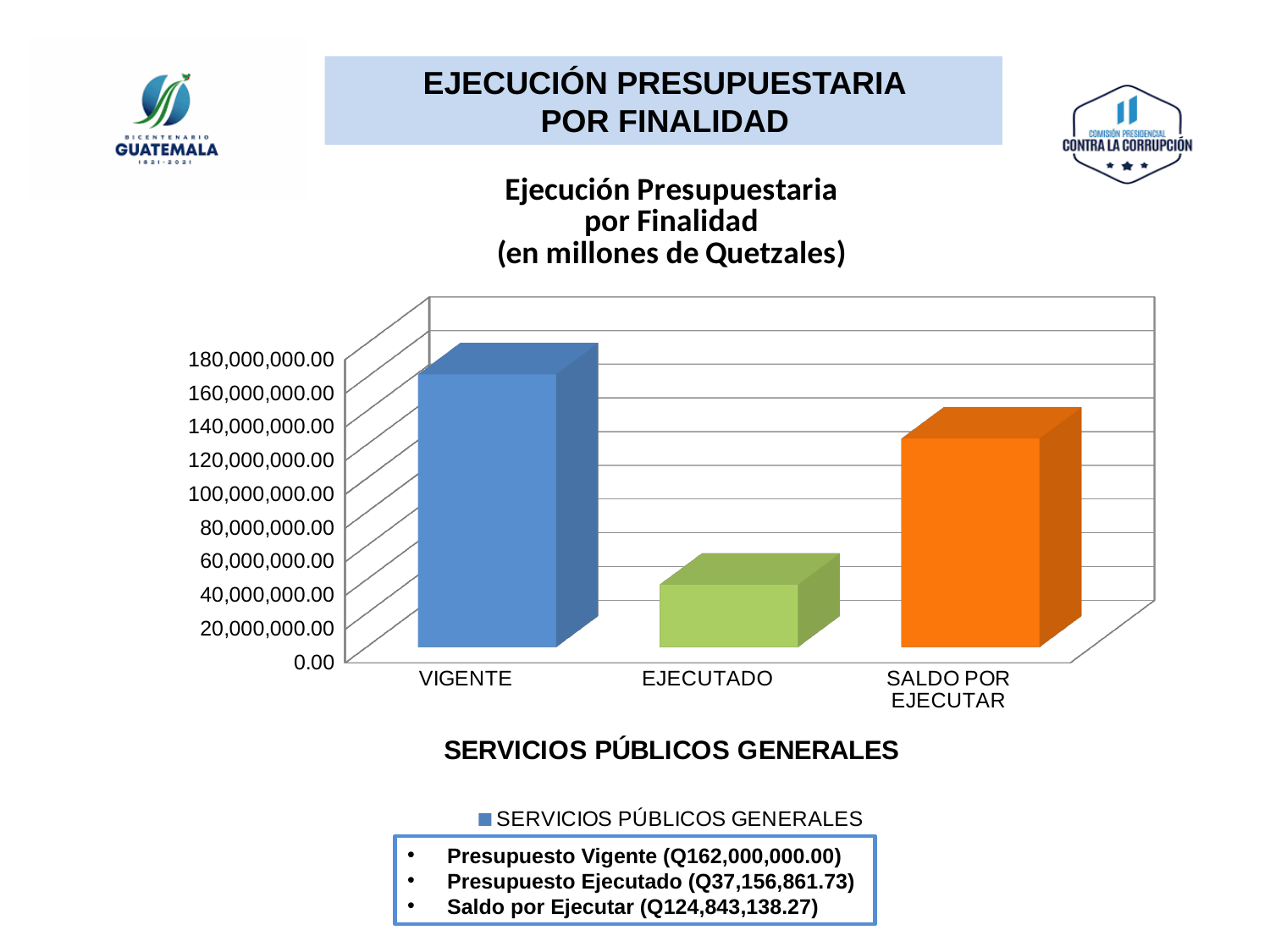
Is the value for VIGENTE greater or less than 140,000,000.00? greater Which category has the highest bar in the chart? VIGENTE What kind of chart is shown on the slide? Bar chart According to the slide, what is the Presupuesto Ejecutado value plotted for EJECUTADO? Q37,156,861.73 How many categories are plotted on the x axis of the chart? 3 What is the name of the series shown in the chart legend? SERVICIOS PÚBLICOS GENERALES Is the value for EJECUTADO greater or less than 60,000,000.00? less How many series does the chart legend list? 1 Which category has the lowest bar in the chart? EJECUTADO According to the slide, what is the Presupuesto Vigente value plotted for VIGENTE? Q162,000,000.00 Is the value for SALDO POR EJECUTAR greater or less than 100,000,000.00? greater Which is larger, the bar for SALDO POR EJECUTAR or the bar for EJECUTADO? SALDO POR EJECUTAR